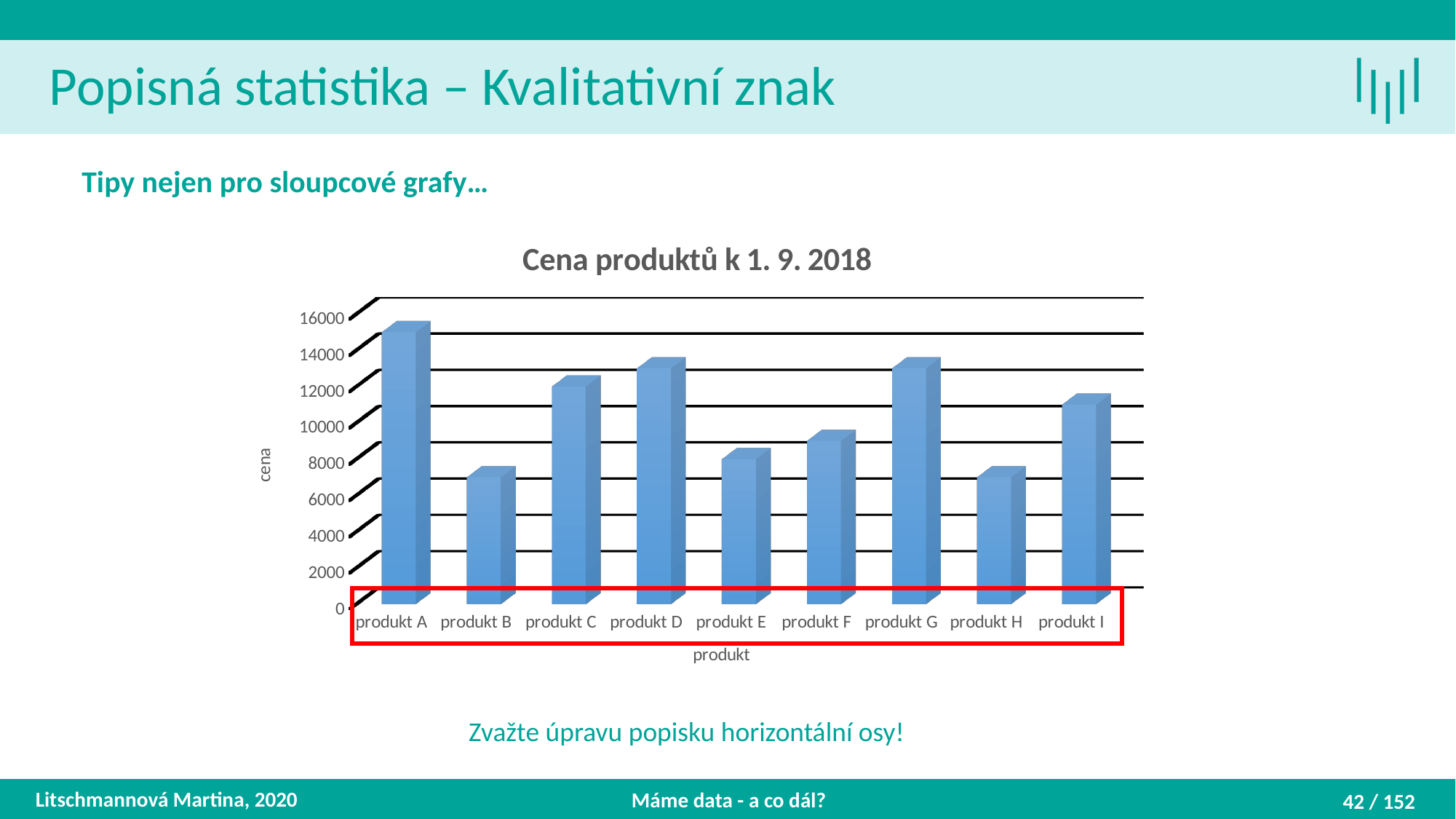
What type of chart is shown on the slide? bar chart Is the value for produkt A greater or less than 14000? greater Which product has the highest value in the chart? produkt A What is the label of the vertical axis of the chart? cena Is the value for produkt I greater or less than 10000? greater Is the value for produkt B greater or less than 8000? less Which is larger, the value for produkt H or produkt I? produkt I How many products (categories) are shown on the x axis of the chart? 9 What is the title of the chart? Cena produktů k 1. 9. 2018 Which is larger, the value for produkt A or produkt C? produkt A